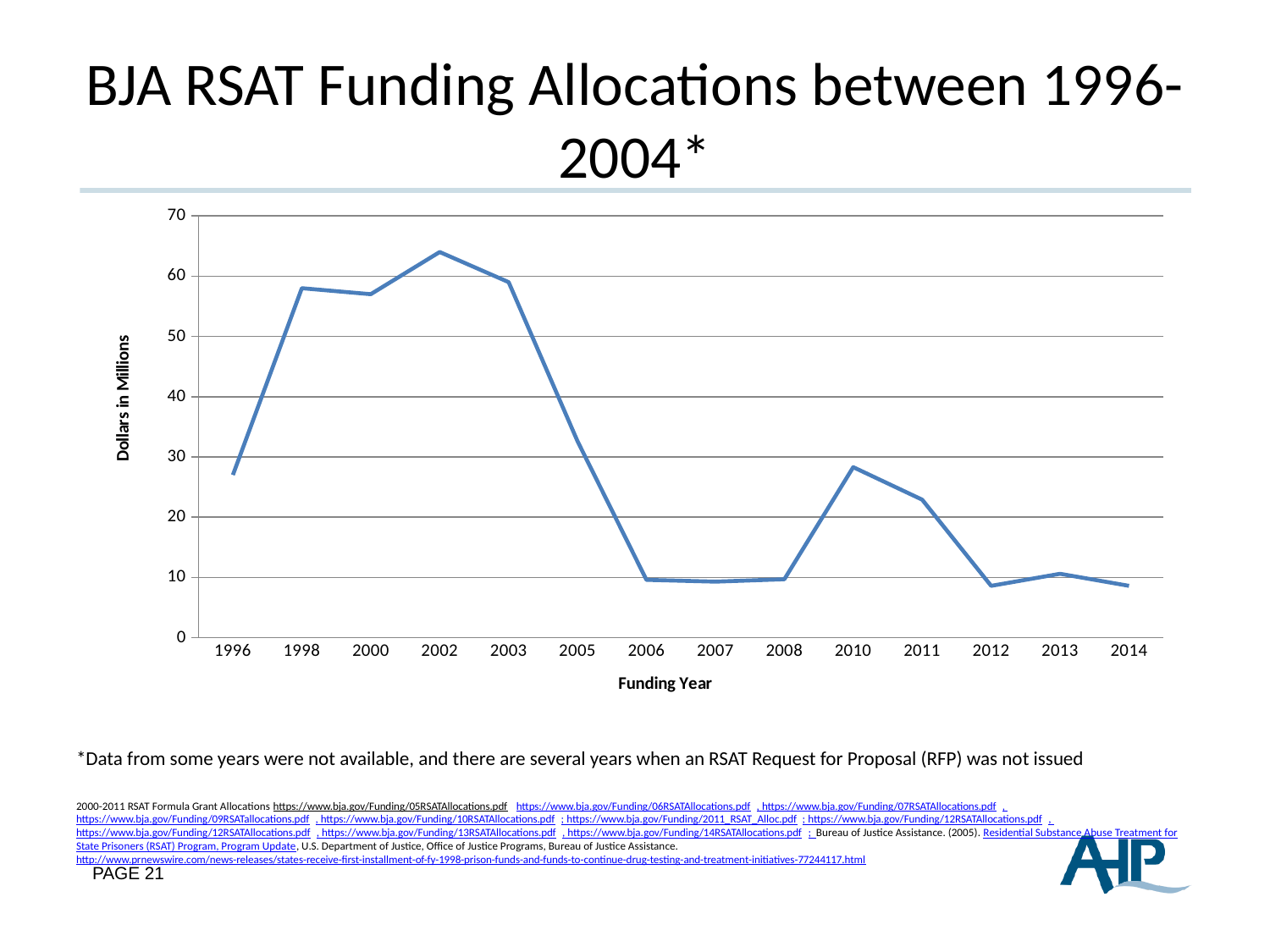
Is the value for 2002 greater or less than 60? greater Is the value for 2010 greater or less than 30? less How many funding years are plotted on the x axis? 14 Which is larger, the value for 2002 or the value for 2003? 2002 Is the value for 2005 greater or less than 40? less What kind of chart is shown on the slide? line chart Which funding year has the highest allocation? 2002 What is the title of the y axis? Dollars in Millions Which is larger, the value for 2010 or the value for 2011? 2010 Do the values rise or fall between 2002 and 2006? fall